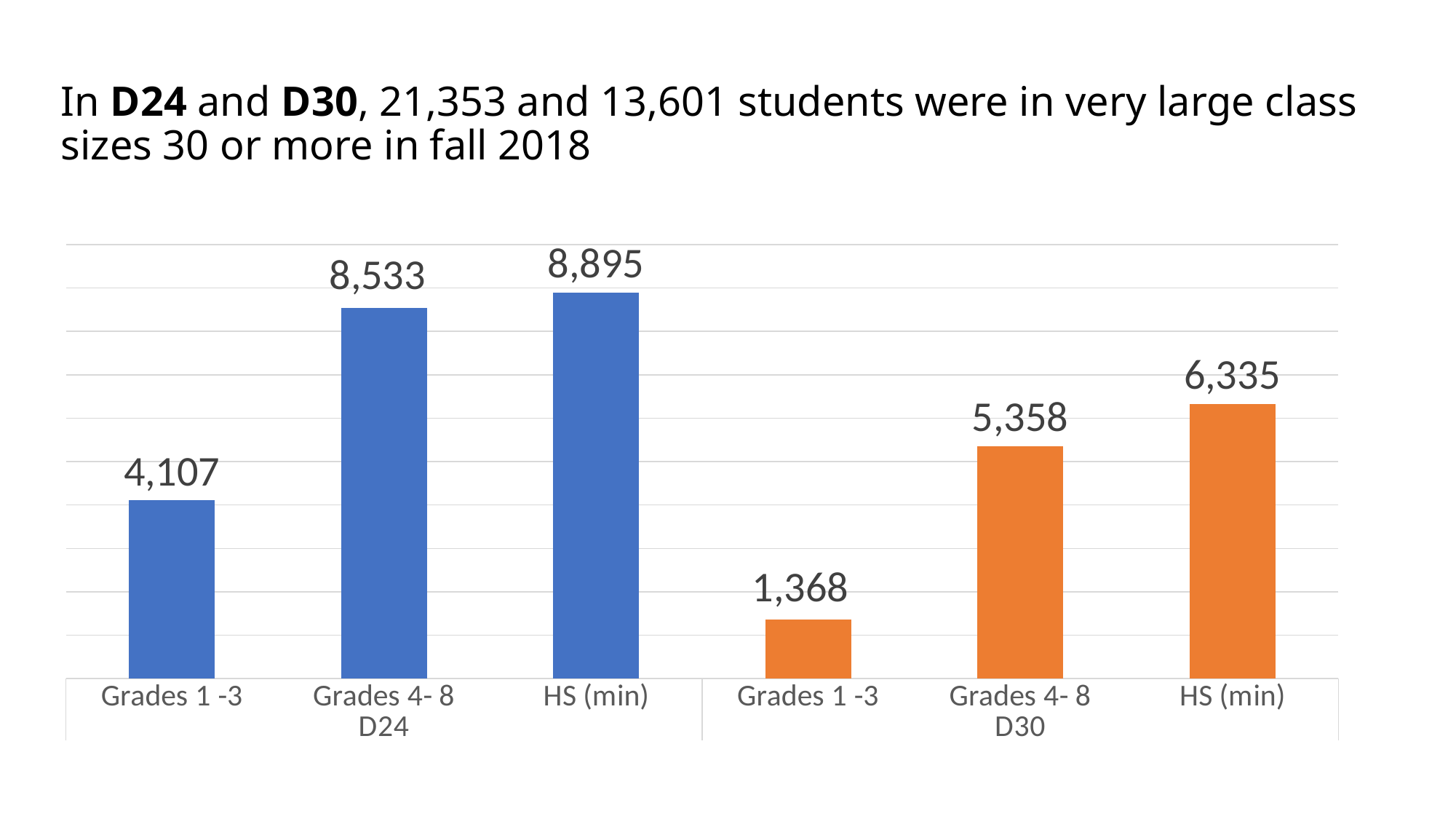
What is the value for Grades 4-8 in D30? 5,358 Which is larger: Grades 1-3 in D24 or Grades 4-8 in D30? Grades 4-8 in D30 How many bars are plotted on the chart? 6 What is the difference between Grades 4-8 in D24 and Grades 4-8 in D30? 3,175 Which bar has the highest value on the chart? HS (min) in D24 Which bar has the lowest value on the chart? Grades 1-3 in D30 Do the values rise or fall from Grades 1-3 to HS (min) within D30? Rise What kind of chart is shown on the slide? Bar chart What is the value for Grades 1-3 in D24? 4,107 What colour are the bars for D30? Orange What is the difference between HS (min) in D24 and Grades 1-3 in D24? 4,788 What is the value for HS (min) in D30? 6,335